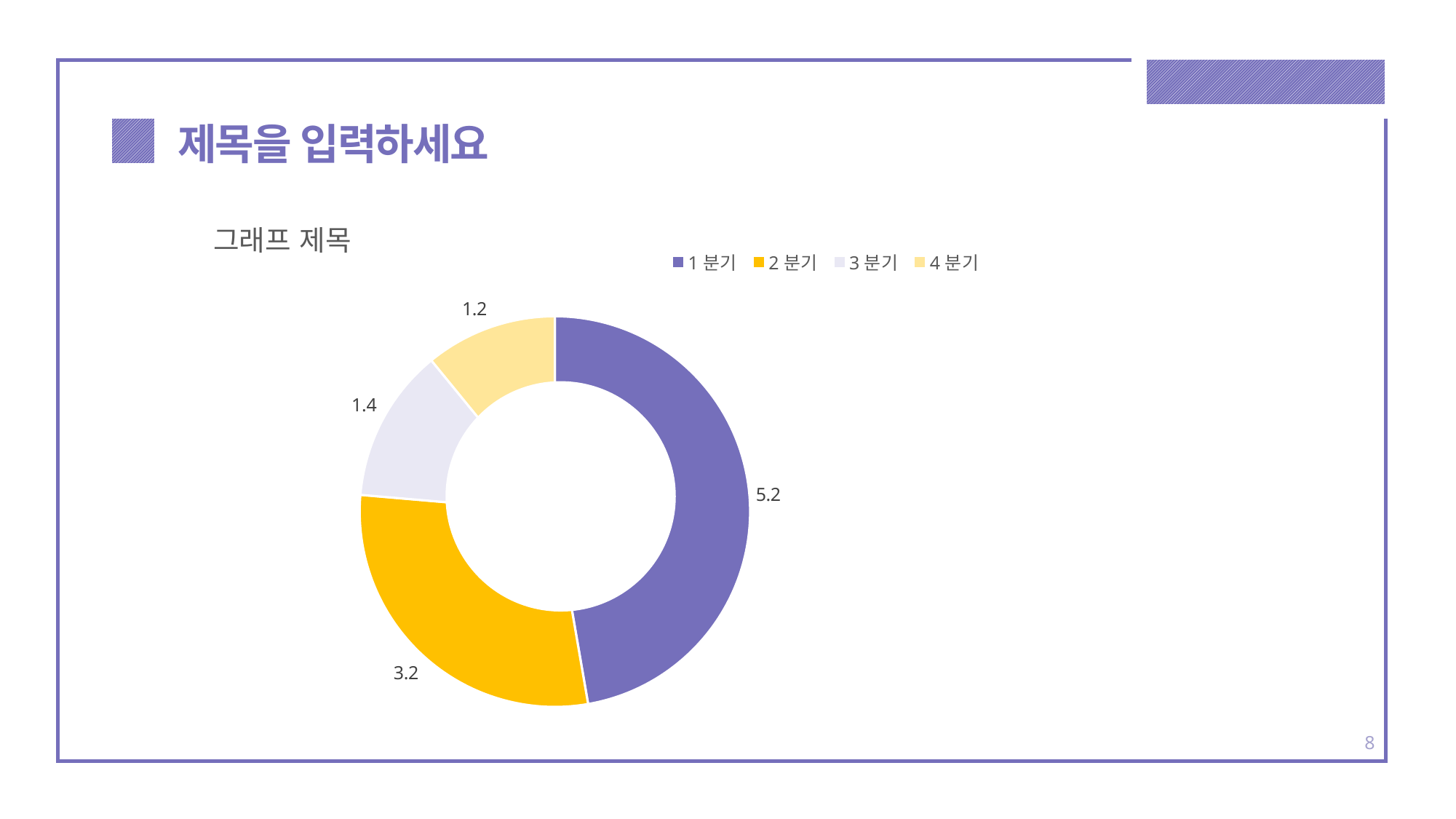
Which is larger, the value for 2 분기 or the value for 3 분기? 2 분기 What is the total of all the values shown in the chart? 11 What kind of chart is shown on the slide? doughnut chart What is the value for 2 분기 in the chart? 3.2 What is the difference between the values for 1 분기 and 2 분기? 2 Which quarter has the largest value in the chart? 1 분기 How many categories are shown in the chart? 4 What is the value for 1 분기 in the chart? 5.2 What is the title of the chart? 그래프 제목 Which quarter has the smallest value in the chart? 4 분기 What is the value for 4 분기 in the chart? 1.2 What is the value for 3 분기 in the chart? 1.4